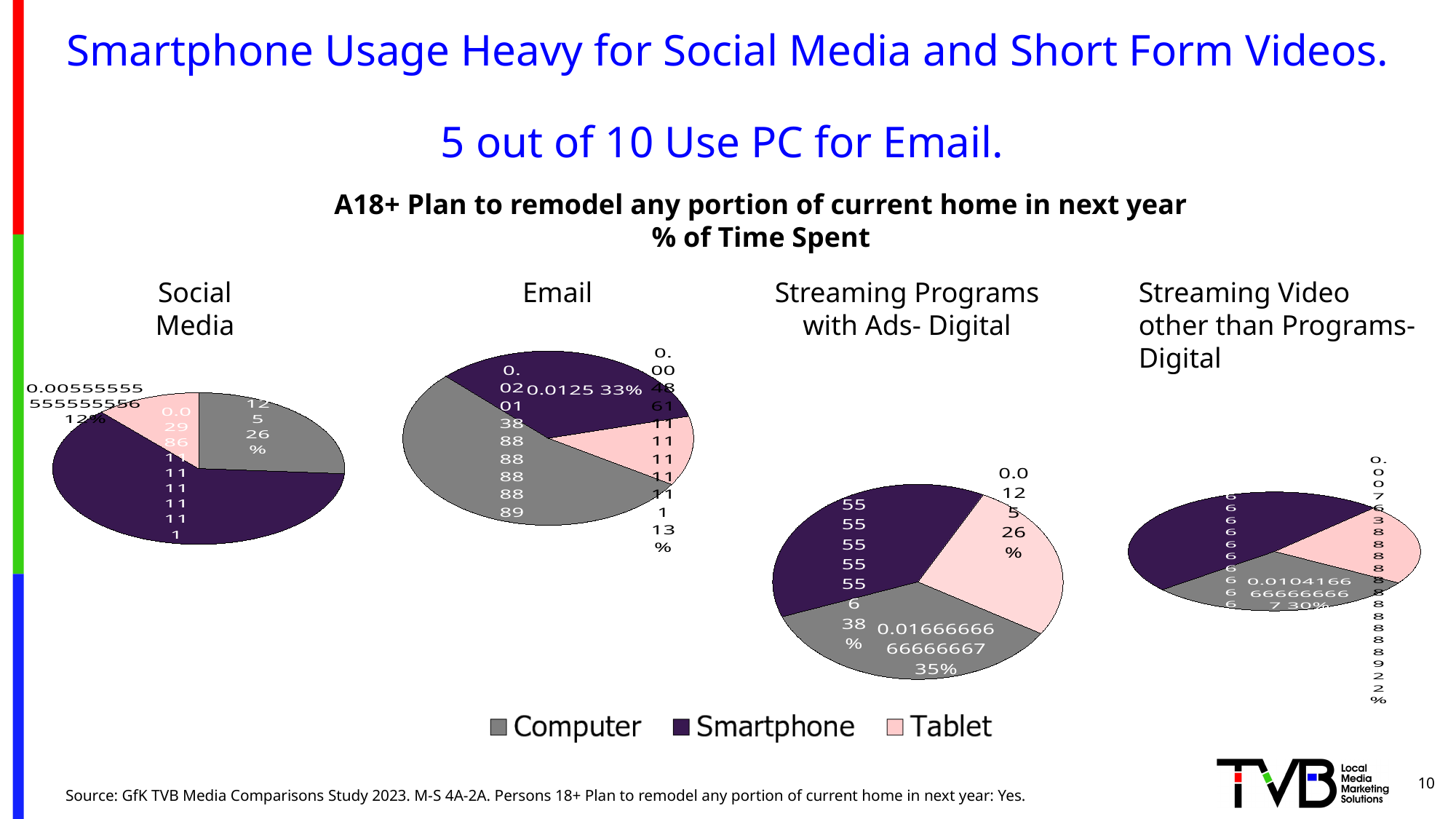
In the Email pie chart, which device has the largest share? Computer In the Social Media pie chart, what percentage is shown for Tablet? 12% In the Streaming Programs with Ads- Digital pie chart, what percentage is shown for Computer? 35% How many series does the legend list? 3 What kind of charts are shown on the slide? Pie charts In the Email pie chart, what percentage is shown for Smartphone? 33% In the Email pie chart, what percentage is shown for Tablet? 13% What are the three legend entries? Computer, Smartphone, Tablet In the Social Media pie chart, what percentage is shown for Computer? 26% In the Streaming Programs with Ads- Digital pie chart, which device has the largest share? Smartphone How many pie charts are on the slide? 4 In the Streaming Programs with Ads- Digital pie chart, what is the difference in percentage points between Smartphone (38%) and Tablet (26%)? 12